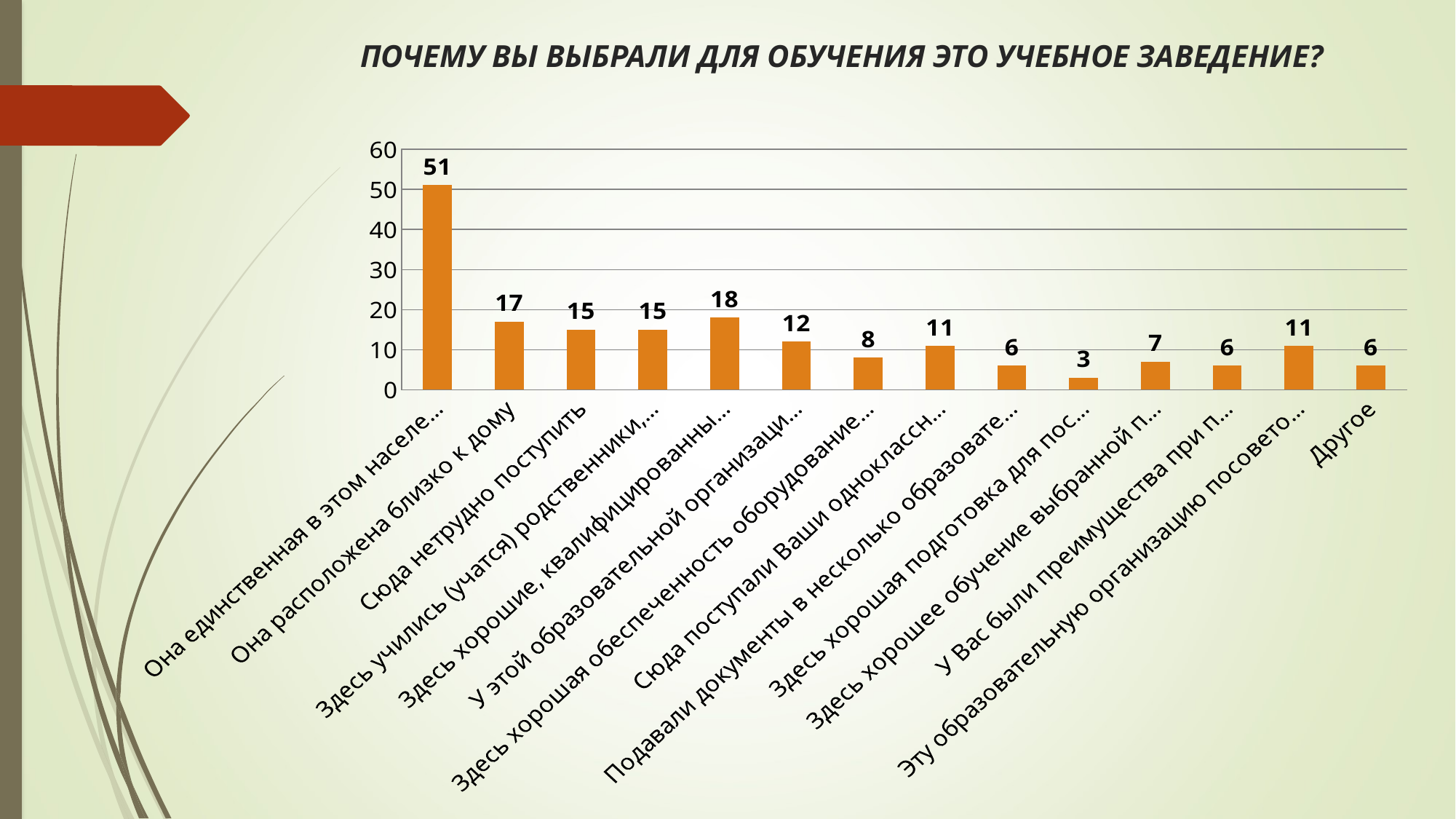
What is the value for the category beginning "Здесь хорошие, квалифицированны..."? 18 What is the difference between the value for "Здесь хорошие, квалифицированны..." and the value for "Здесь хорошая подготовка для пос..."? 15 What is the difference between the value for "Она единственная в этом населе..." and the value for "Она расположена близко к дому"? 34 What is the value for "Она расположена близко к дому"? 17 What is the value for "Другое"? 6 Which category has the highest value? Она единственная в этом населе... Which category has the lowest value? Здесь хорошая подготовка для пос... How many categories are shown in the chart? 14 What is the title of the slide? ПОЧЕМУ ВЫ ВЫБРАЛИ ДЛЯ ОБУЧЕНИЯ ЭТО УЧЕБНОЕ ЗАВЕДЕНИЕ? What is the value for "Сюда нетрудно поступить"? 15 What type of chart is shown on the slide? bar chart Which is larger: the value for "Сюда нетрудно поступить" or the value for "Другое"? Сюда нетрудно поступить